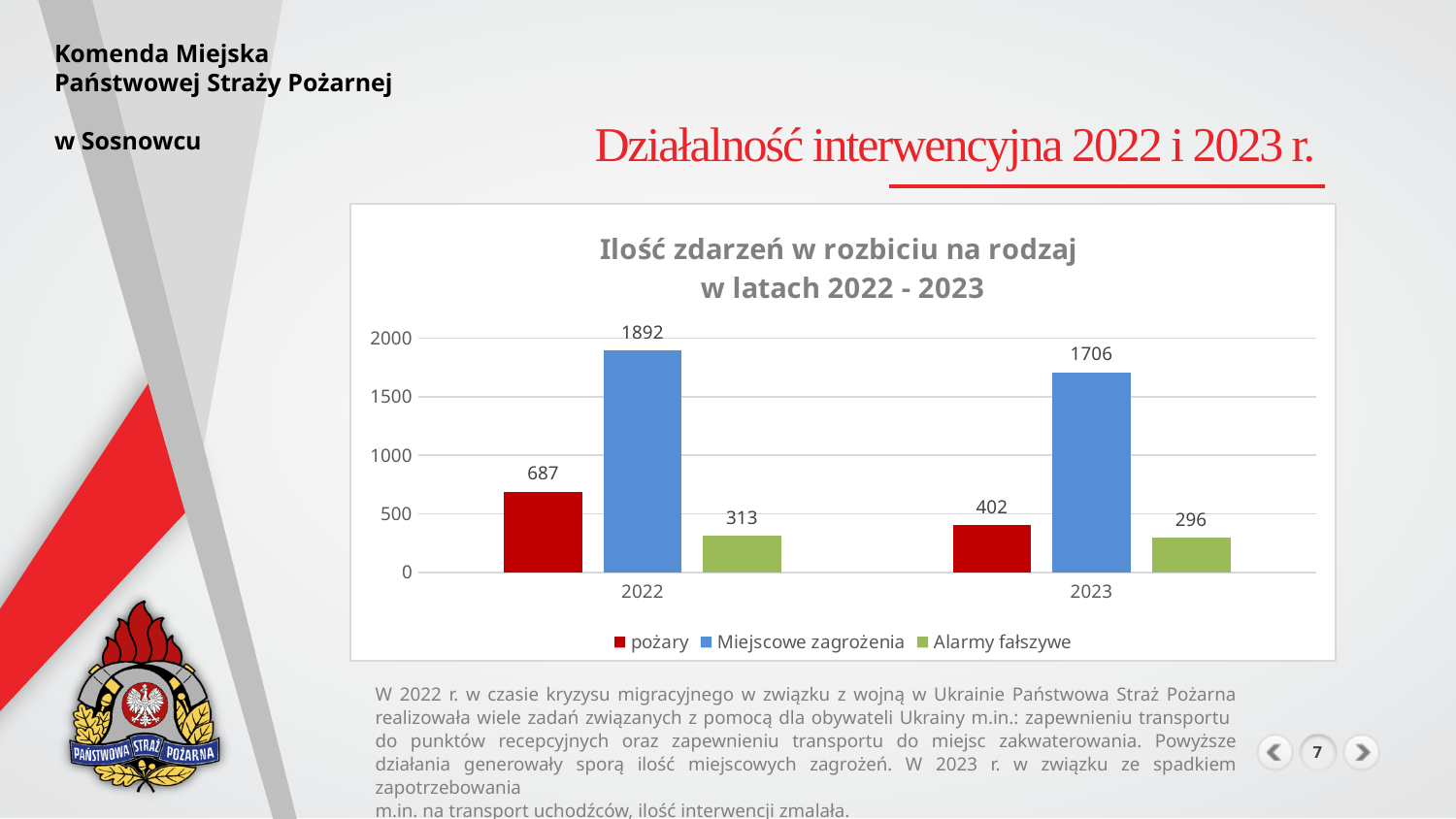
What is the value for pożary in 2022? 687 What is the difference between Miejscowe zagrożenia in 2022 and in 2023? 186 What kind of chart is shown on the slide? bar chart What is the value for Alarmy fałszywe in 2022? 313 What is the value for Miejscowe zagrożenia in 2023? 1706 Which is larger: pożary in 2022 or pożary in 2023? pożary in 2022 Which series has the lowest value in 2023? Alarmy fałszywe What is the difference between pożary in 2022 and pożary in 2023? 285 What colour are the bars for Miejscowe zagrożenia? blue Is the value for Miejscowe zagrożenia in 2023 greater or less than 1500? greater Which series has the highest value in 2022? Miejscowe zagrożenia How many series does the legend list? 3